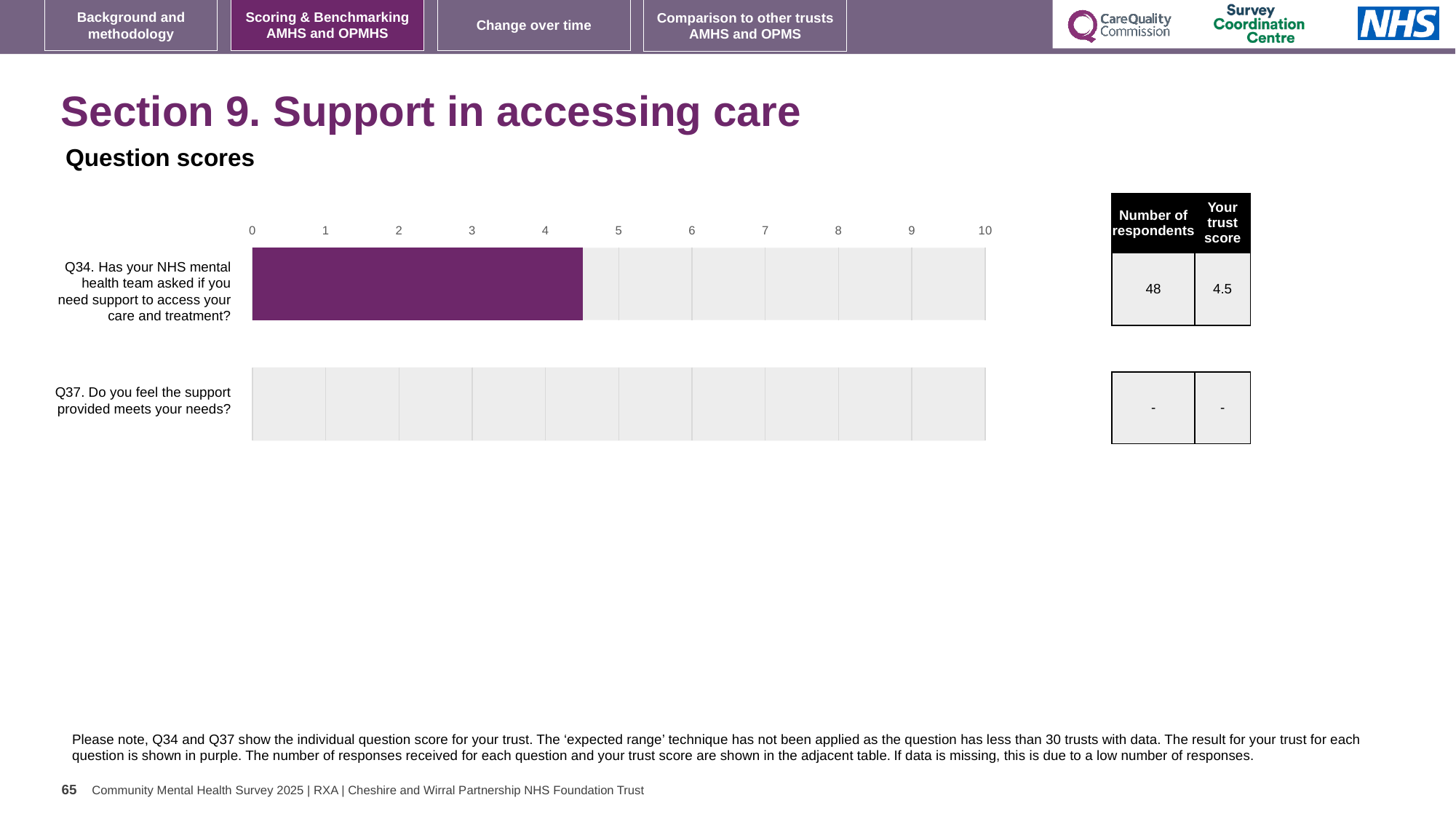
What kind of chart is shown on the slide? bar chart Is the value for Q34 greater or less than 5? less How many respondents answered Q34? 48 What colour is the bar showing the trust's result for Q34? purple What is shown as the number of respondents for Q37? - How many questions are listed on the chart? 2 What is the maximum value shown on the chart's axis? 10 Which question has a plotted bar on the chart, Q34 or Q37? Q34 What is the trust score for Q34 (Has your NHS mental health team asked if you need support to access your care and treatment?)? 4.5 What is shown as the trust score for Q37 (Do you feel the support provided meets your needs?)? - Is the value for Q34 greater or less than 4? greater